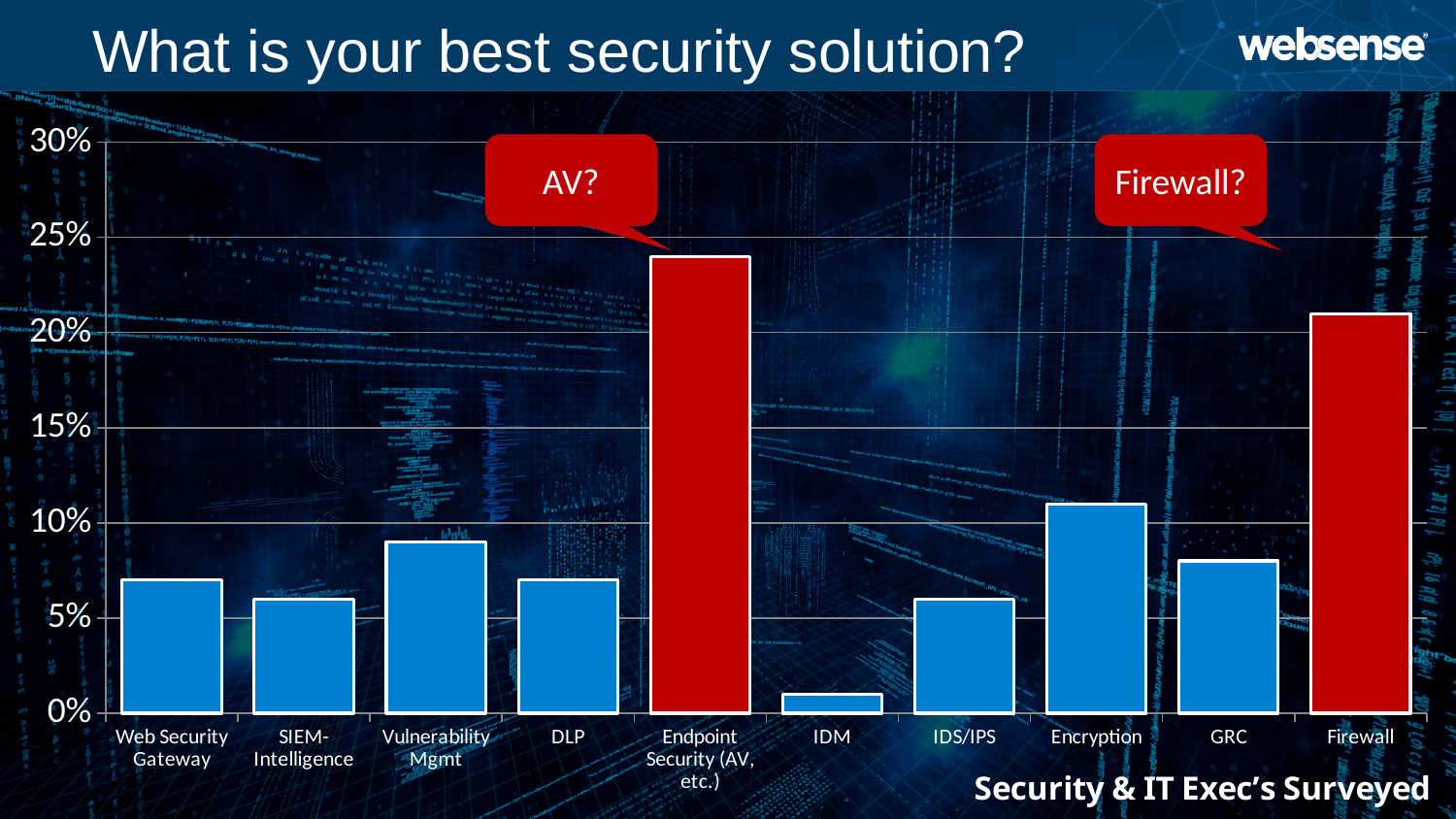
Which security solution has the lowest bar? IDM Is the value for Endpoint Security (AV, etc.) greater or less than 20%? greater Is the value for Firewall greater or less than 20%? greater Which security solution has the highest bar? Endpoint Security (AV, etc.) Which is larger, the value for Encryption or the value for GRC? Encryption Which is larger, the value for Endpoint Security (AV, etc.) or the value for Firewall? Endpoint Security (AV, etc.) What kind of chart is shown on the slide? bar chart What is the title of the chart on the slide? Security & IT Exec’s Surveyed How many security solution categories are shown on the x axis? 10 Is the value for GRC greater or less than 10%? less